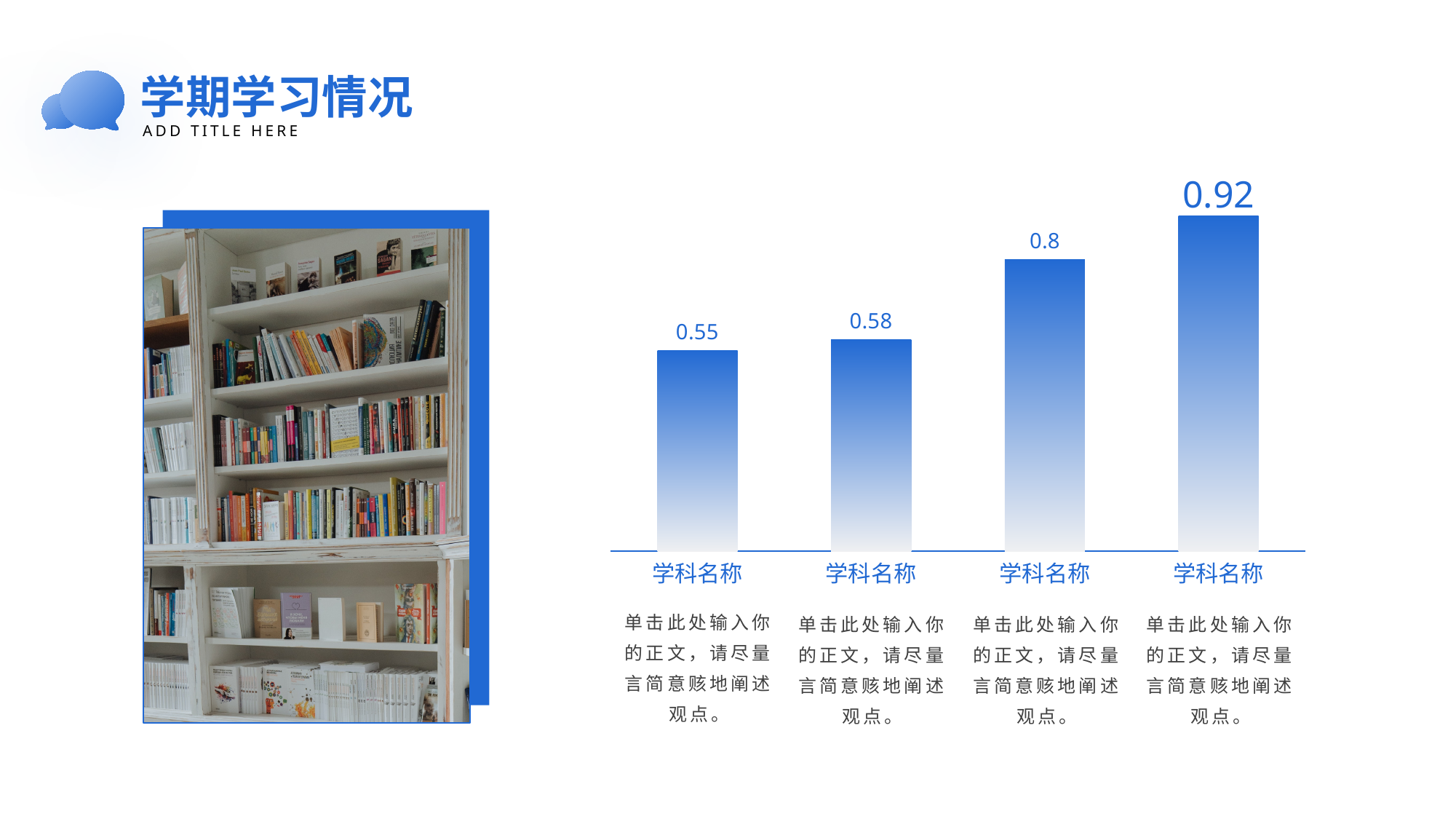
What is the difference between the third bar (0.8) and the second bar (0.58)? 0.22 Do the bar values rise or fall from left to right? rise What is the value of the second bar from the left? 0.58 What label is shown under each bar of the chart? 学科名称 Which bar has the highest value? the fourth bar from the left (0.92) What is the difference between the fourth bar (0.92) and the first bar (0.55)? 0.37 What kind of chart is shown on the slide? bar chart What is the value of the fourth bar from the left? 0.92 What is the value of the first bar from the left? 0.55 What is the value of the third bar from the left? 0.8 Which bar has the lowest value? the first bar from the left (0.55) How many bars does the chart show? 4